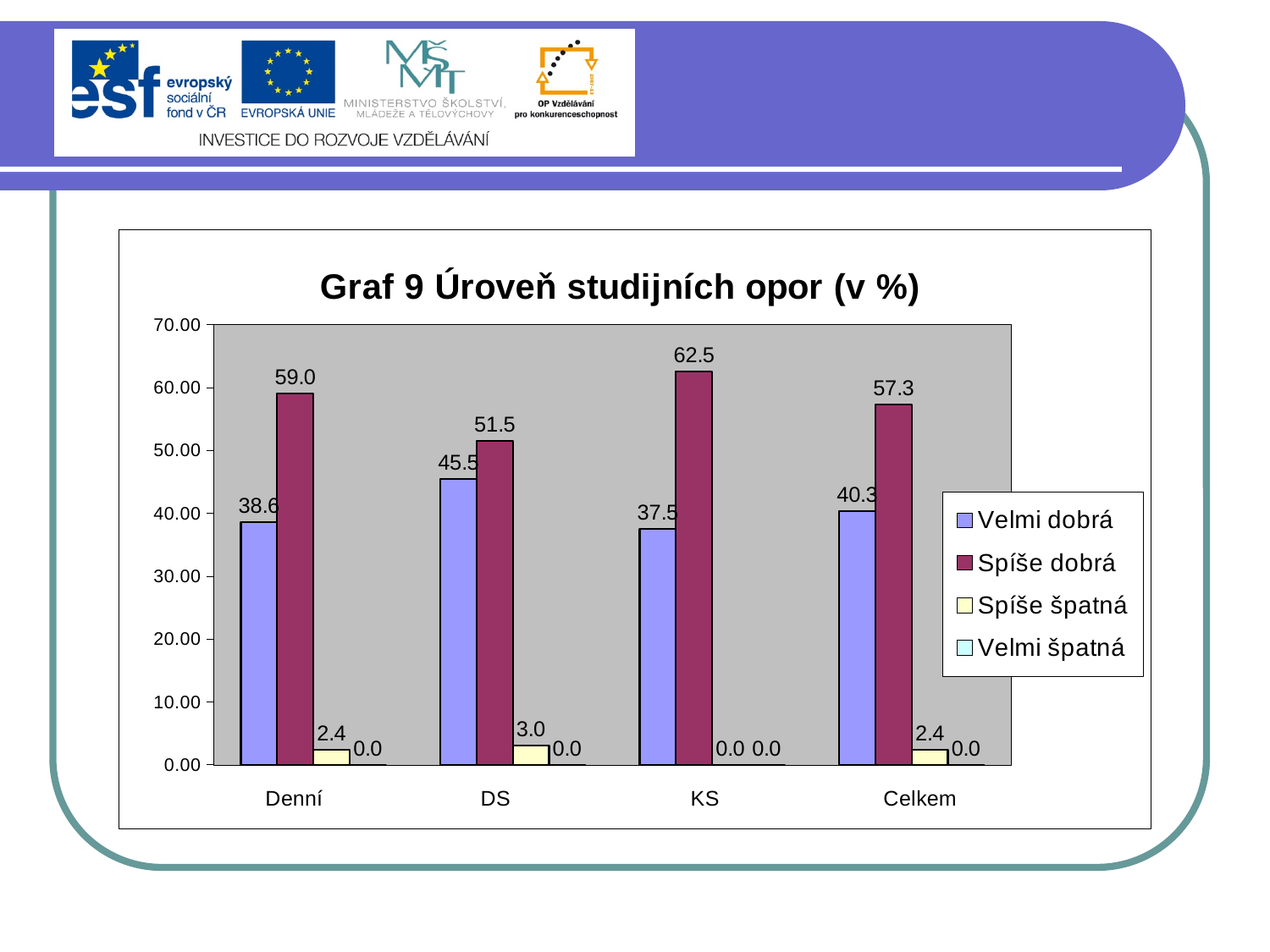
What is the title of the chart? Graf 9 Úroveň studijních opor (v %) How many categories are shown on the x axis? 4 What is the value for Velmi dobrá in the Denní category? 38.6 What is the value for Spíše špatná in the DS category? 3.0 How many series does the legend list? 4 What is the difference between the Spíše dobrá and Velmi dobrá values in the Celkem category? 17.0 Which category has the highest value for Spíše dobrá? KS Is the value for Spíše dobrá in the DS category greater or less than 50.00? greater Which category has the lowest value for Velmi dobrá? KS What kind of chart is shown on the slide? bar chart What is the value for Spíše dobrá in the KS category? 62.5 Which is larger: the Velmi dobrá value for DS or the Velmi dobrá value for Celkem? DS